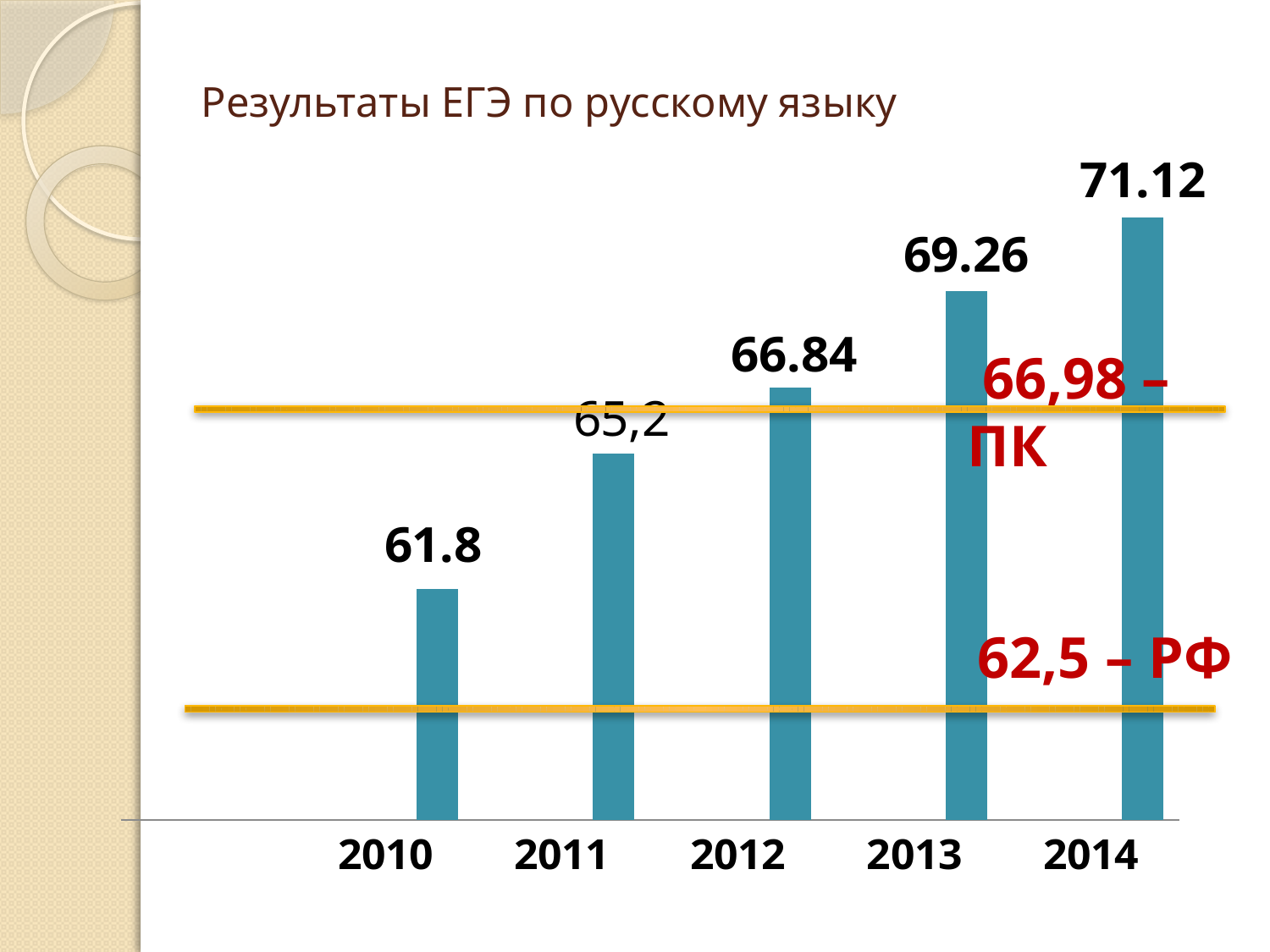
Which year has the highest value? 2014 What is the value for 2014? 71.12 Do the values rise or fall from 2010 to 2014? rise What is the value for 2012? 66.84 What is the value for 2010? 61.8 Which year has the lowest value? 2010 What is the difference between the values for 2014 and 2010? 9.32 What is the value for 2013? 69.26 What is the difference between the values for 2013 and 2012? 2.42 What kind of chart is this? bar chart Which is larger, the value for 2012 or the value for 2013? 2013 How many years are shown on the x axis? 5